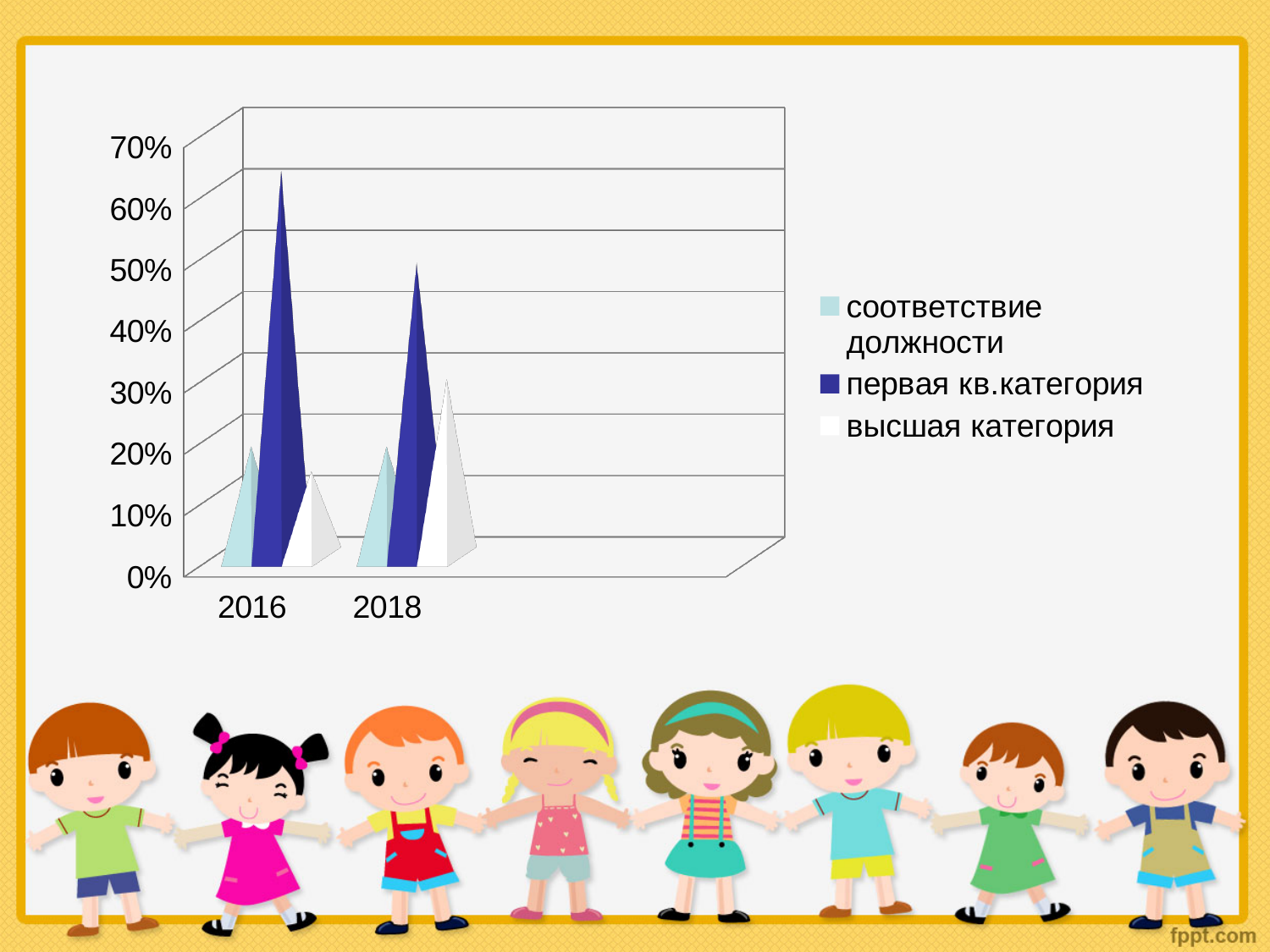
Which series has the lowest value in 2016? высшая категория Is the value for высшая категория larger in 2016 or in 2018? 2018 Which series has the highest value in 2016? первая кв.категория What colour represents первая кв.категория in the legend? dark blue Which series has the highest value in 2018? первая кв.категория Is the value for первая кв.категория larger in 2016 or in 2018? 2016 Is the value for высшая категория in 2016 greater or less than 30%? less Is the value for первая кв.категория in 2016 greater or less than 50%? greater How many categories (years) are shown on the x axis? 2 Does the value for первая кв.категория rise or fall from 2016 to 2018? fall How many series does the legend list? 3 What kind of chart is shown on the slide? bar chart